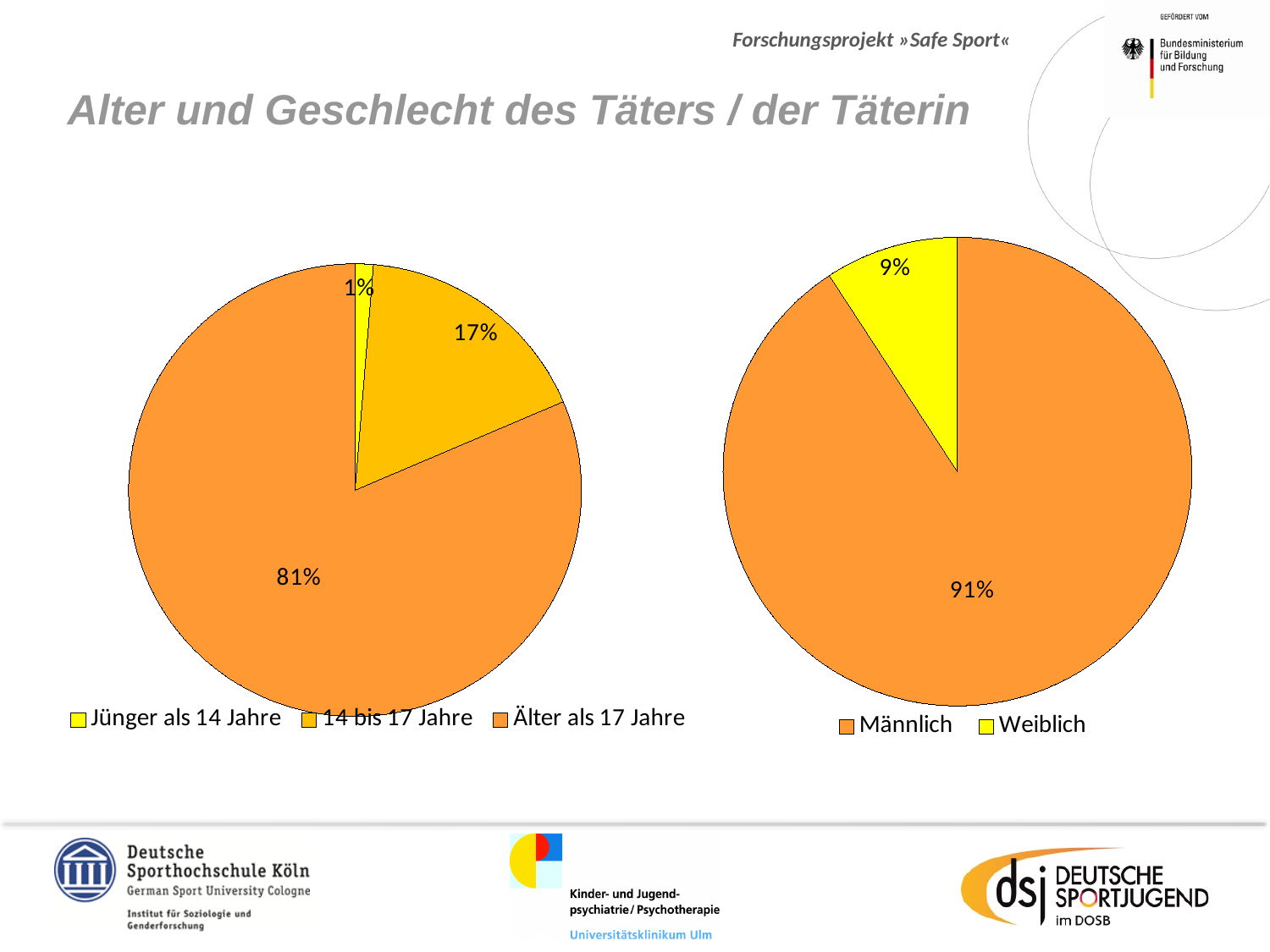
In the left pie chart, what is the difference in percentage points between 'Älter als 17 Jahre' and '14 bis 17 Jahre'? 64 In the left pie chart, what share is labelled for 'Älter als 17 Jahre'? 81% In the right pie chart, what is the difference in percentage points between Männlich and Weiblich? 82 In the right pie chart, what share is labelled for 'Männlich'? 91% What type of chart is shown on the right side of the slide? Pie chart In the left pie chart, what share is labelled for 'Jünger als 14 Jahre'? 1% In the right pie chart, what share is labelled for 'Weiblich'? 9% In the right pie chart, which category has the larger slice, Männlich or Weiblich? Männlich In the left pie chart, what share is labelled for '14 bis 17 Jahre'? 17% How many categories does the legend of the left pie chart list? 3 In the left pie chart, which category has the smallest slice? Jünger als 14 Jahre In the left pie chart, which category has the largest slice? Älter als 17 Jahre